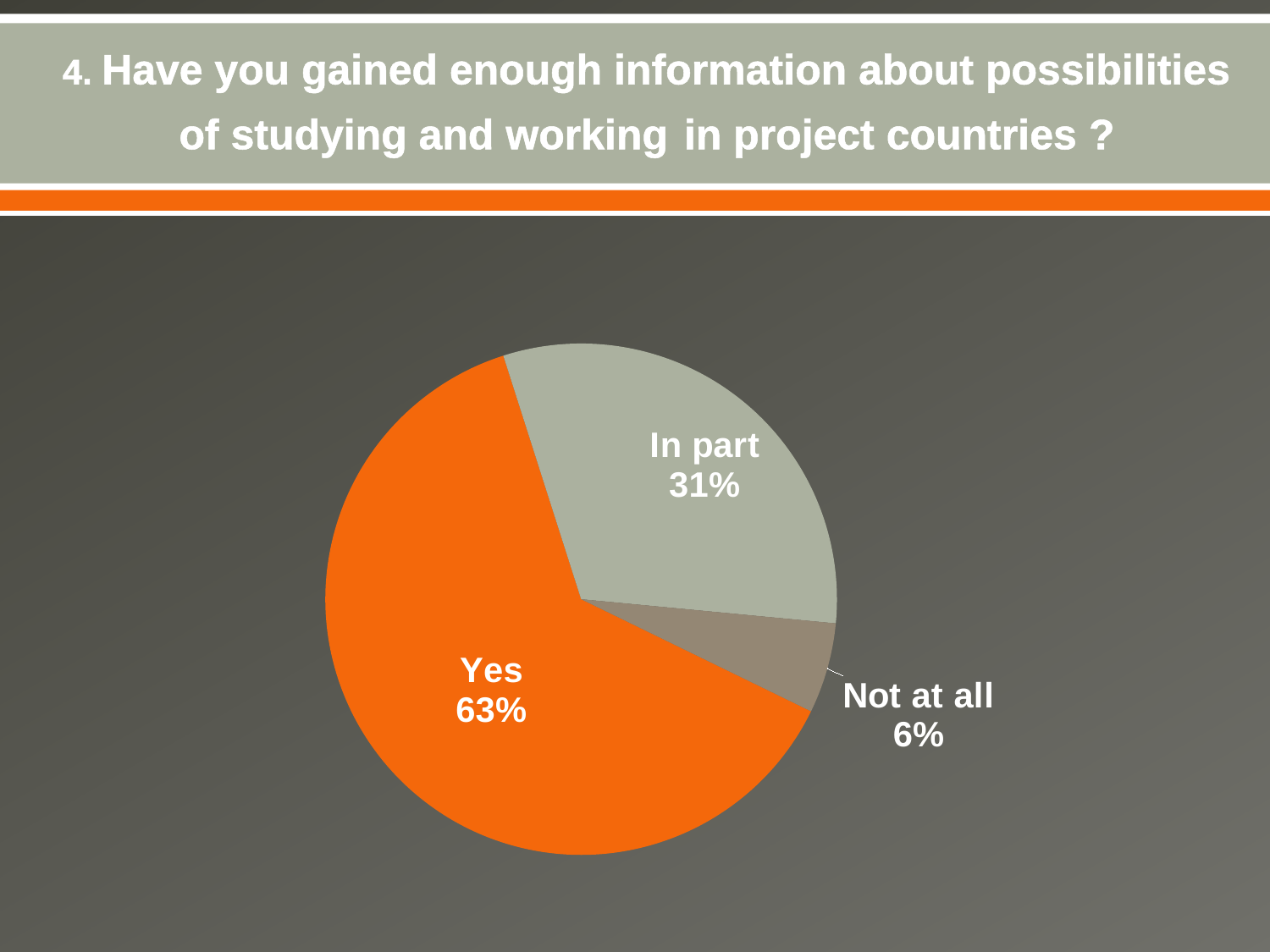
Which response has the smallest slice of the pie? Not at all What is the difference in percentage points between "Yes" and "In part"? 32 How many slices does the pie chart have? 3 What kind of chart is shown on the slide? pie chart What colour is the "Yes" slice of the pie? orange What question does the chart on the slide answer? Have you gained enough information about possibilities of studying and working in project countries? What is the difference in percentage points between "In part" and "Not at all"? 25 What share of respondents answered "Yes"? 63% Which response has the largest slice of the pie? Yes What share of respondents answered "Not at all"? 6% Which is larger, the share for "In part" or the share for "Not at all"? In part What share of respondents answered "In part"? 31%